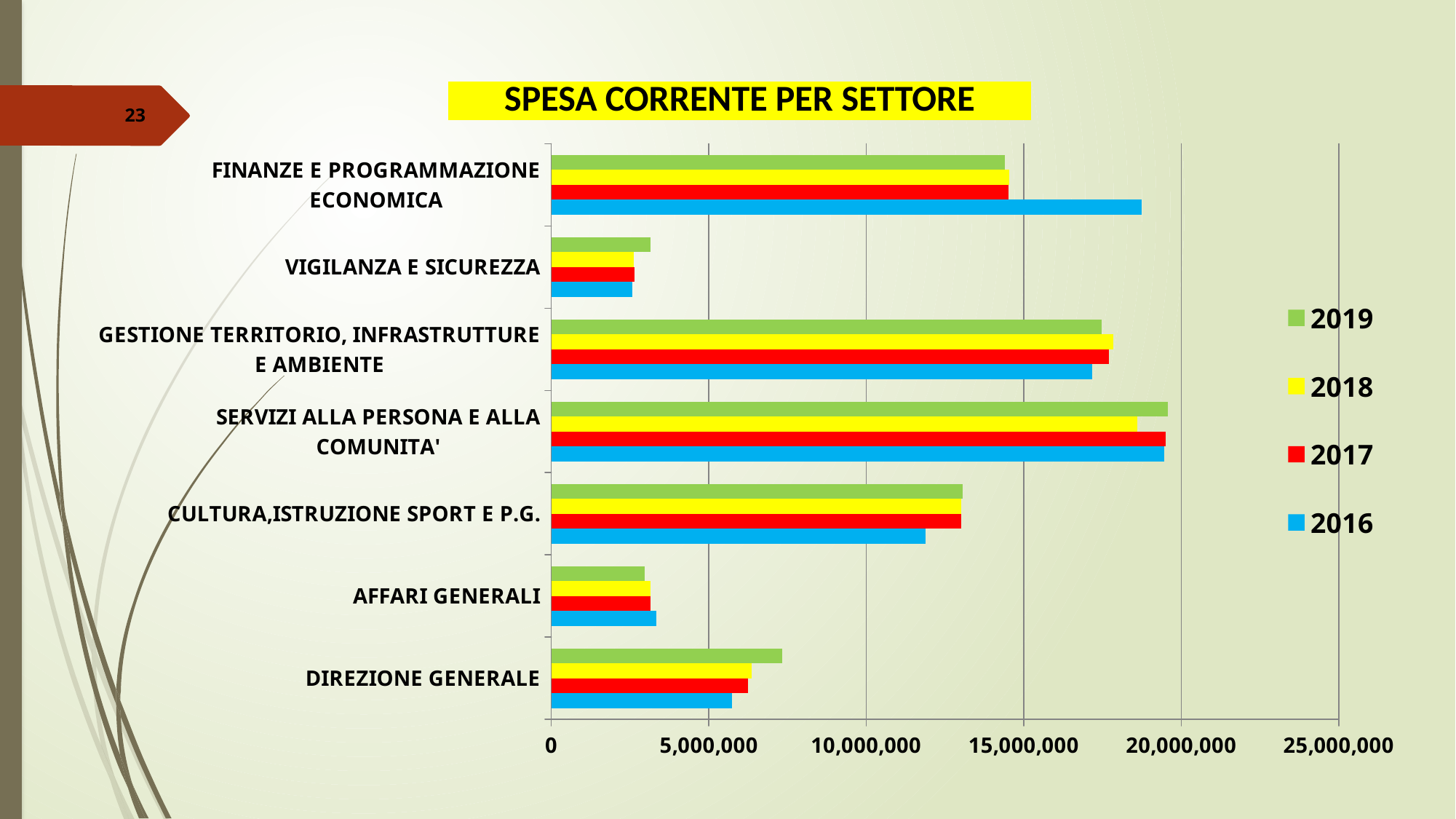
How many sector categories are shown on the chart? 7 Is the 2016 value for FINANZE E PROGRAMMAZIONE ECONOMICA greater or less than 15,000,000? greater Is the 2019 value for DIREZIONE GENERALE greater or less than 5,000,000? greater How many series does the legend list? 4 Is the 2016 value for CULTURA,ISTRUZIONE SPORT E P.G. greater or less than 10,000,000? greater Which sector has the highest 2019 value? SERVIZI ALLA PERSONA E ALLA COMUNITA' Which colour represents 2016 in the legend? blue What is the title of the chart? SPESA CORRENTE PER SETTORE For FINANZE E PROGRAMMAZIONE ECONOMICA, which is larger: the 2016 value or the 2019 value? 2016 What kind of chart is shown on the slide? bar chart For DIREZIONE GENERALE, which is larger: the 2019 value or the 2016 value? 2019